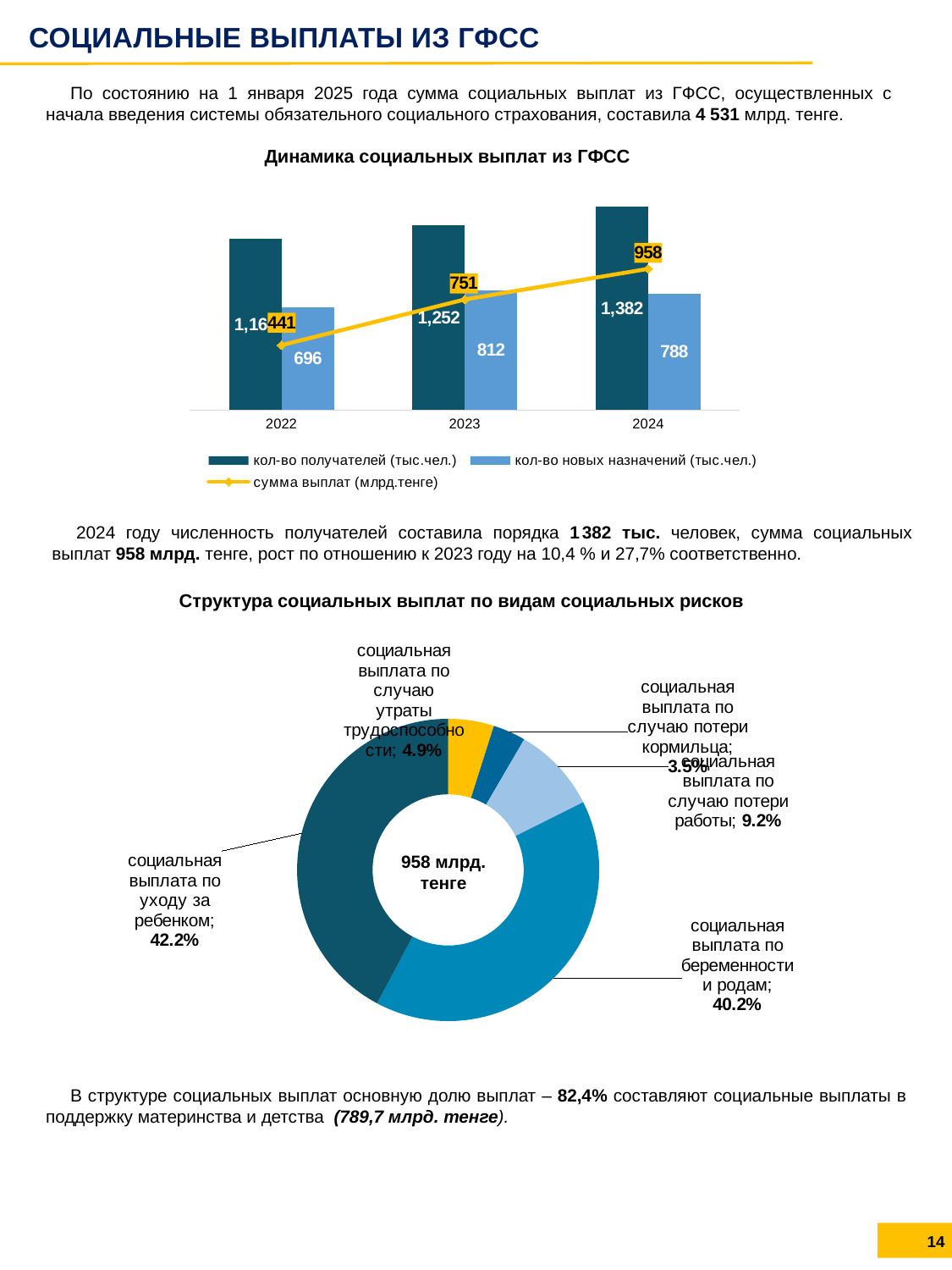
In the chart 'Динамика социальных выплат из ГФСС', which year has the highest 'сумма выплат (млрд.тенге)'? 2024 What kind of chart is 'Структура социальных выплат по видам социальных рисков'? pie (donut) chart In the chart 'Динамика социальных выплат из ГФСС', which year has the larger value of 'кол-во новых назначений (тыс.чел.)', 2023 or 2024? 2023 In the chart 'Динамика социальных выплат из ГФСС', what is the value of 'сумма выплат (млрд.тенге)' for 2022? 441 In the chart 'Структура социальных выплат по видам социальных рисков', which category has the largest share? социальная выплата по уходу за ребенком How many series does the legend of the chart 'Динамика социальных выплат из ГФСС' list? 3 In the chart 'Динамика социальных выплат из ГФСС', what is the value of 'кол-во новых назначений (тыс.чел.)' for 2023? 812 In the chart 'Динамика социальных выплат из ГФСС', what is the value of 'кол-во получателей (тыс.чел.)' for 2024? 1,382 In the chart 'Динамика социальных выплат из ГФСС', does 'сумма выплат (млрд.тенге)' rise or fall from 2022 to 2024? rise In the chart 'Структура социальных выплат по видам социальных рисков', what share is 'социальная выплата по уходу за ребенком'? 42.2% In the chart 'Динамика социальных выплат из ГФСС', what is the difference between 'сумма выплат (млрд.тенге)' in 2024 and in 2023? 207 How many years are shown on the x axis of the chart 'Динамика социальных выплат из ГФСС'? 3